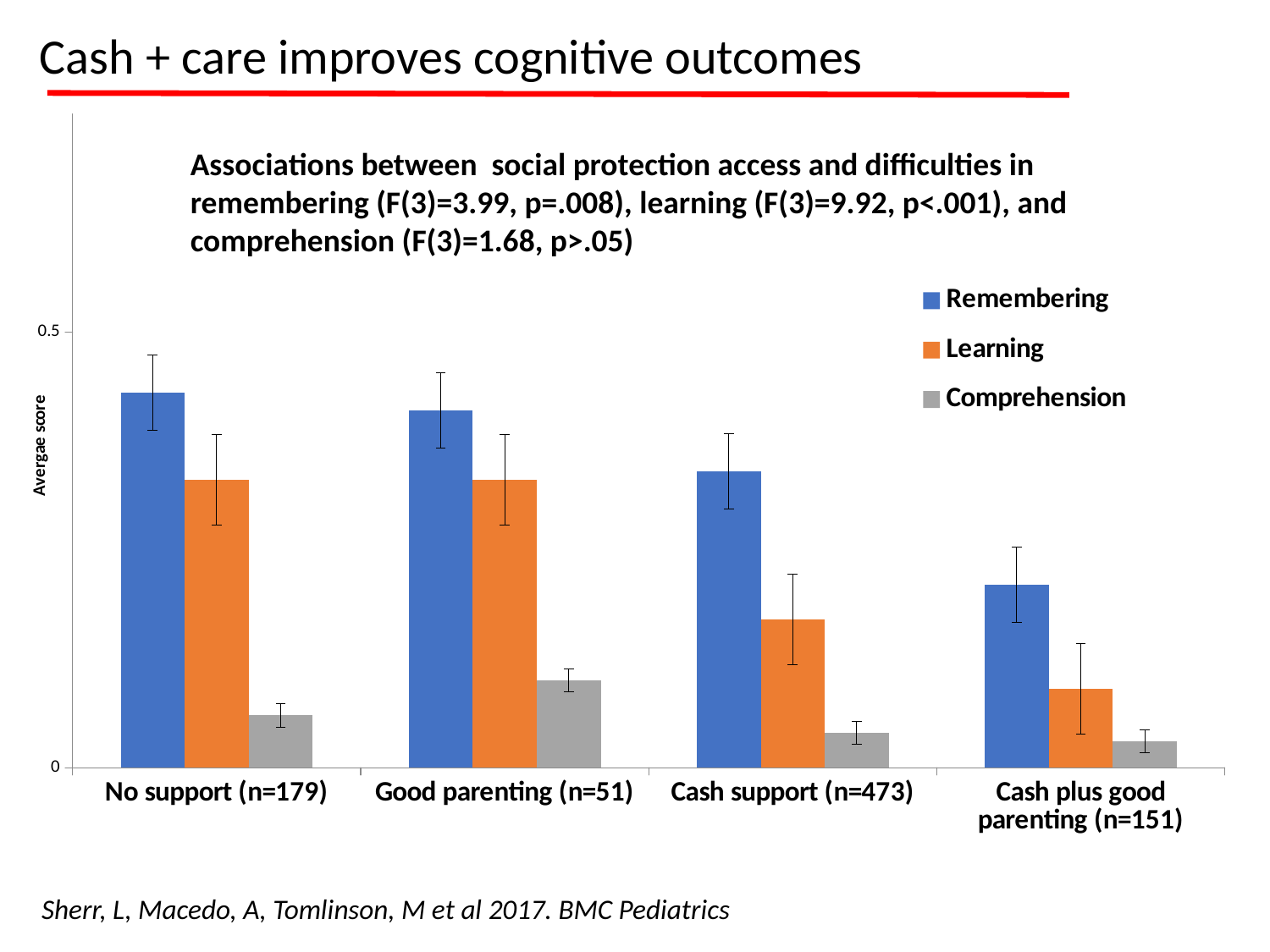
Which category has the highest Remembering value? No support (n=179) What kind of chart is shown on the slide? bar chart Is the Remembering value for No support (n=179) greater or less than 0.5? less Which category has the lowest Learning value? Cash plus good parenting (n=151) Within the Cash support (n=473) category, which series has the highest value? Remembering Is the Remembering value for No support (n=179) larger or smaller than the Remembering value for Cash plus good parenting (n=151)? larger Do the Remembering values rise or fall moving from No support to Cash plus good parenting along the x axis? fall Is the Learning value for Cash support (n=473) larger or smaller than the Learning value for Good parenting (n=51)? smaller Which category has the lowest Comprehension value? Cash plus good parenting (n=151) How many categories are shown along the x axis? 4 How many series does the legend list? 3 What is the label on the y axis? Avergae score